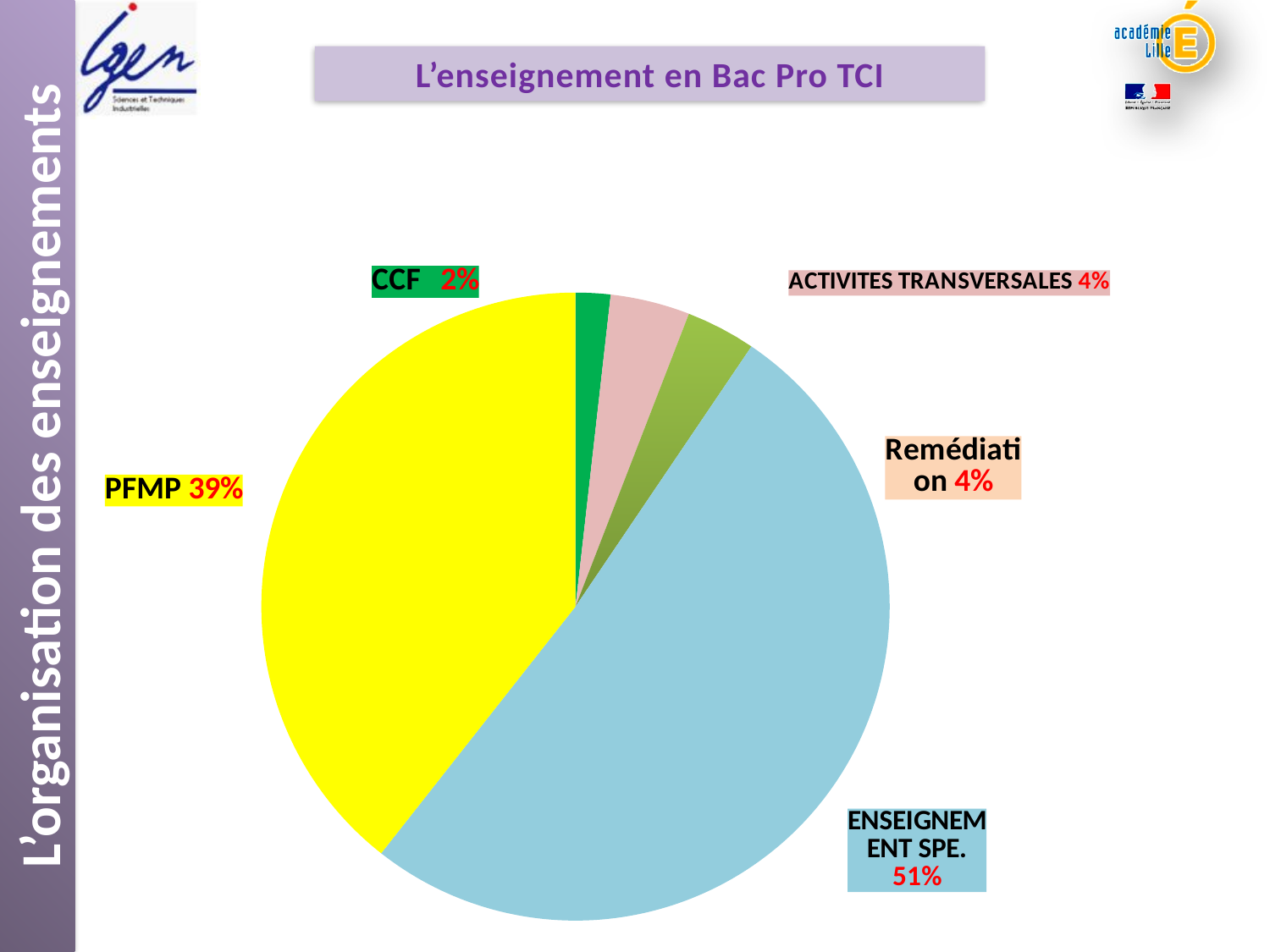
Which category has the smallest slice of the pie? CCF How many slices does the pie chart have? 5 What is the title of the chart? L'enseignement en Bac Pro TCI What share of the pie does ENSEIGNEMENT SPE. represent? 51% What is the value shown for ACTIVITES TRANSVERSALES? 4% Which is larger, the PFMP slice or the Remédiation slice? PFMP What is the difference between the ENSEIGNEMENT SPE. share and the PFMP share? 12% What is the value shown for Remédiation? 4% What is the value shown for PFMP? 39% What is the value shown for CCF? 2% Which category has the largest slice of the pie? ENSEIGNEMENT SPE. What kind of chart is shown on the slide? pie chart